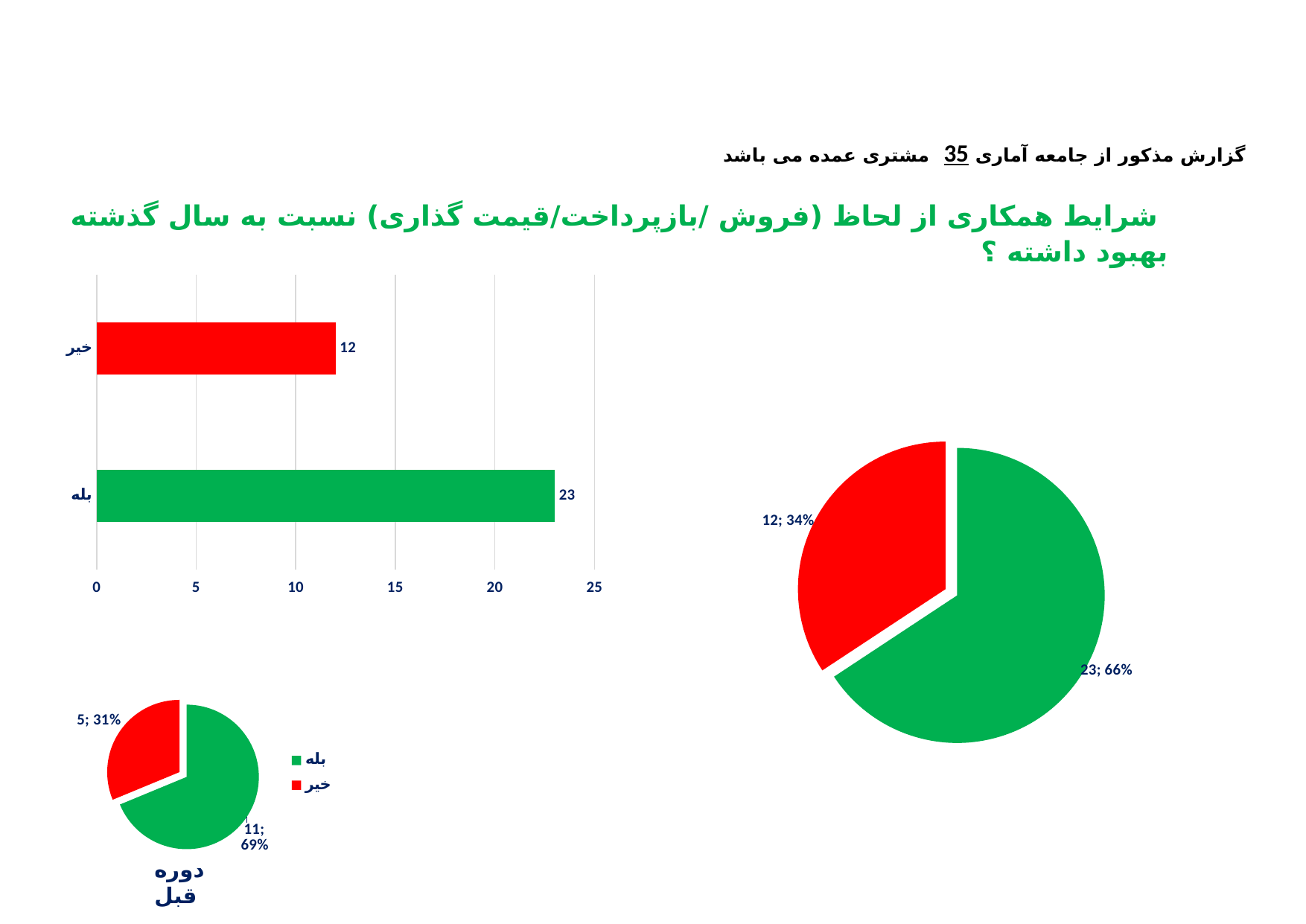
In the large pie chart on the right, what value is shown for the خیر slice? 12 In the bar chart on the left, which category has the highest value? بله In the bar chart on the left, what is the value for بله? 23 How many entries does the legend next to the small pie chart list? 2 What kind of chart is the chart on the top left of the slide? bar chart How many categories does the bar chart on the left show? 2 In the bar chart on the left, what is the difference between the values for بله and خیر? 11 In the small pie chart labelled دوره قبل, which slice is larger, بله or خیر? بله In the bar chart on the left, what is the value for خیر? 12 In the large pie chart on the right, what share does the بله slice have? 66% In the small pie chart labelled دوره قبل at the bottom left, what value is shown for the بله slice? 11 In the small pie chart labelled دوره قبل at the bottom left, what share does the خیر slice have? 31%